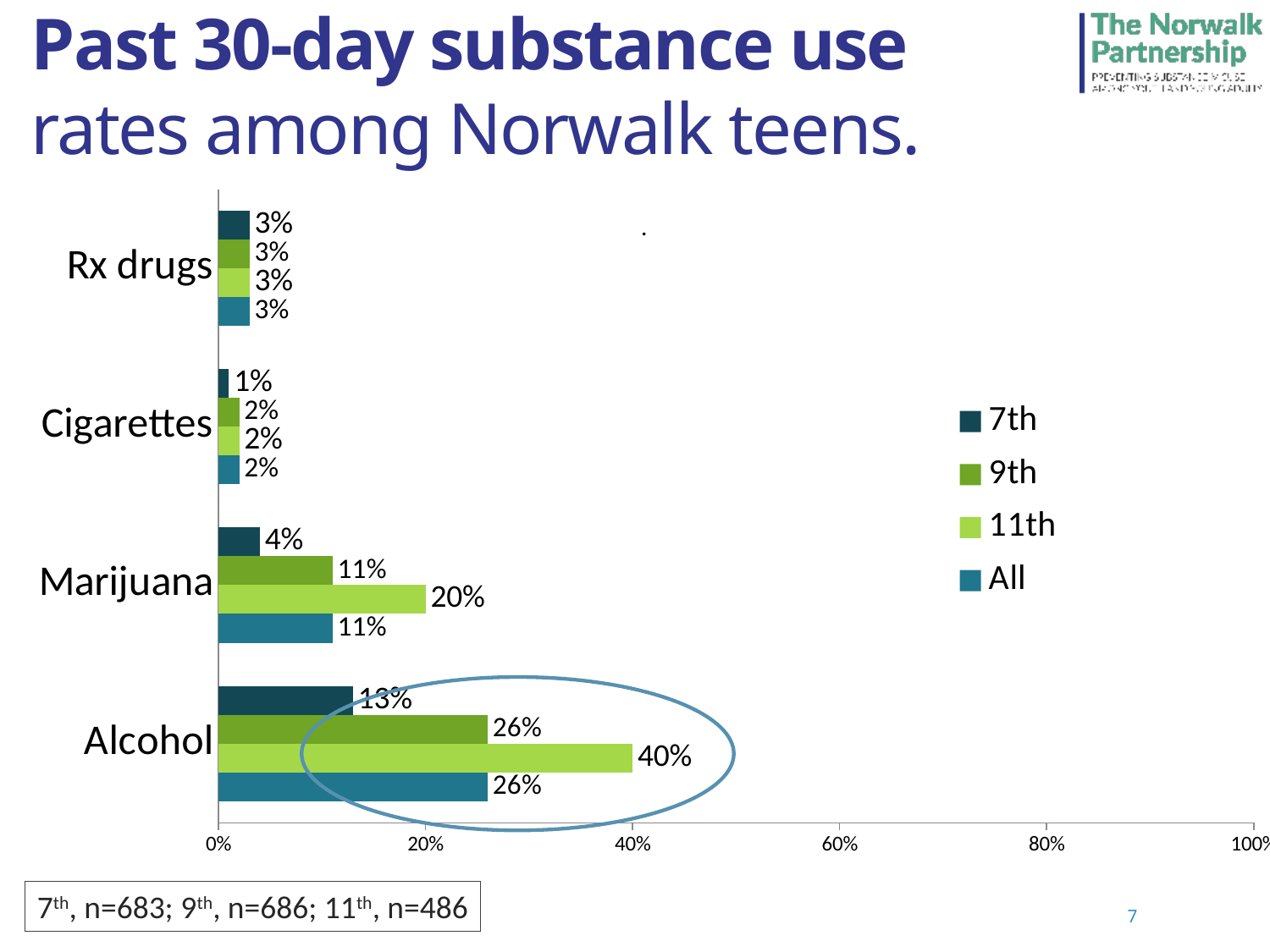
How many substance categories are shown on the chart? 4 Which substance has the highest use rate among 11th graders? Alcohol Is the 11th grade alcohol use rate greater or less than 60%? less How many series does the legend list? 4 Which is larger: the 11th grade marijuana rate or the 9th grade marijuana rate? 11th grade marijuana rate What is the past 30-day alcohol use rate for 11th graders? 40% What is the Rx drugs use rate for All students? 3% What is the cigarette use rate for 7th graders? 1% Which substance has the lowest use rate among 7th graders? Cigarettes What is the difference between the 11th grade and 9th grade alcohol use rates? 14% What is the marijuana use rate for 9th graders? 11% What kind of chart is shown on the slide? Bar chart